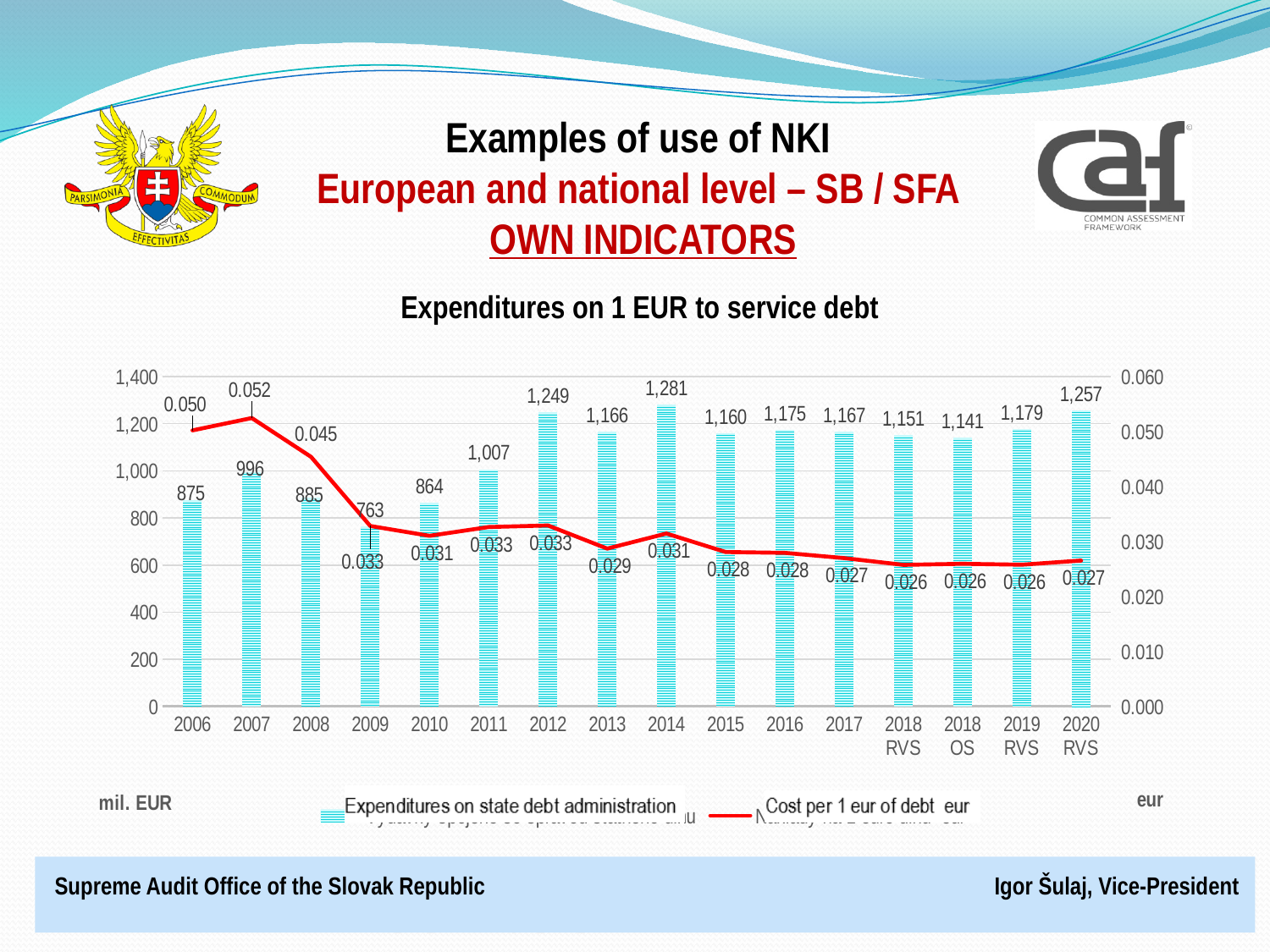
Does the Cost per 1 eur of debt generally rise or fall from 2006 to 2020 RVS? Fall What is the title of the chart? Expenditures on 1 EUR to service debt Which is larger, the Expenditures on state debt administration for 2019 RVS or for 2018 OS? 2019 RVS What is the difference in Expenditures on state debt administration between 2012 and 2011? 242 What kind of chart is this? Combined bar and line chart What is the Cost per 1 eur of debt for 2007? 0.052 Which year has the highest Expenditures on state debt administration? 2014 What is the value of Expenditures on state debt administration for 2014? 1,281 Which year has the lowest Expenditures on state debt administration? 2009 Which year has the highest Cost per 1 eur of debt? 2007 How many categories are shown on the x axis? 16 How many series does the legend list? 2